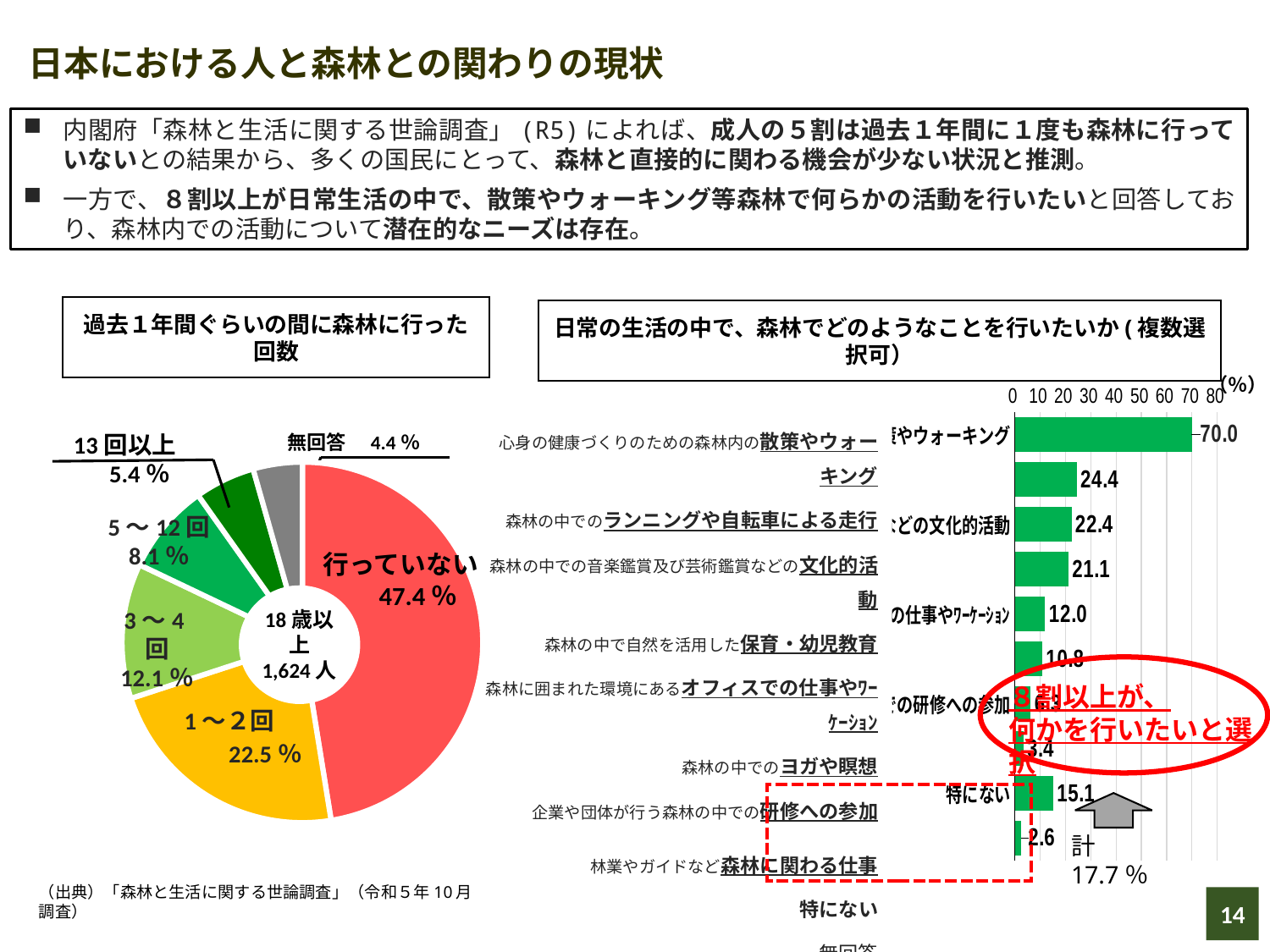
In the left chart 「過去1年間ぐらいの間に森林に行った回数」, which category has the smallest share? 無回答 In the left chart 「過去1年間ぐらいの間に森林に行った回数」, how many respondents (18歳以上) are shown in the centre? 1,624人 In the right chart 「日常の生活の中で、森林でどのようなことを行いたいか」, what kind of chart is it? bar chart In the left chart 「過去1年間ぐらいの間に森林に行った回数」, what is the difference between the shares for 「3～4回」 and 「5～12回」? 4.0％ In the left chart 「過去1年間ぐらいの間に森林に行った回数」, what is the share for 「行っていない」? 47.4％ In the left chart titled 「過去1年間ぐらいの間に森林に行った回数」, what kind of chart is it? pie chart In the right chart 「日常の生活の中で、森林でどのようなことを行いたいか」, what is the value for 「特にない」? 15.1 In the right chart 「日常の生活の中で、森林でどのようなことを行いたいか」, which category has the highest value? 散策やウォーキング In the right chart 「日常の生活の中で、森林でどのようなことを行いたいか」, what is the value for 「散策やウォーキング」? 70.0 In the left chart 「過去1年間ぐらいの間に森林に行った回数」, what is the share for 「1～2回」? 22.5％ In the right chart 「日常の生活の中で、森林でどのようなことを行いたいか」, is the value for 「散策やウォーキング」 greater or less than 60? greater In the left chart 「過去1年間ぐらいの間に森林に行った回数」, how many slices does the pie have? 6